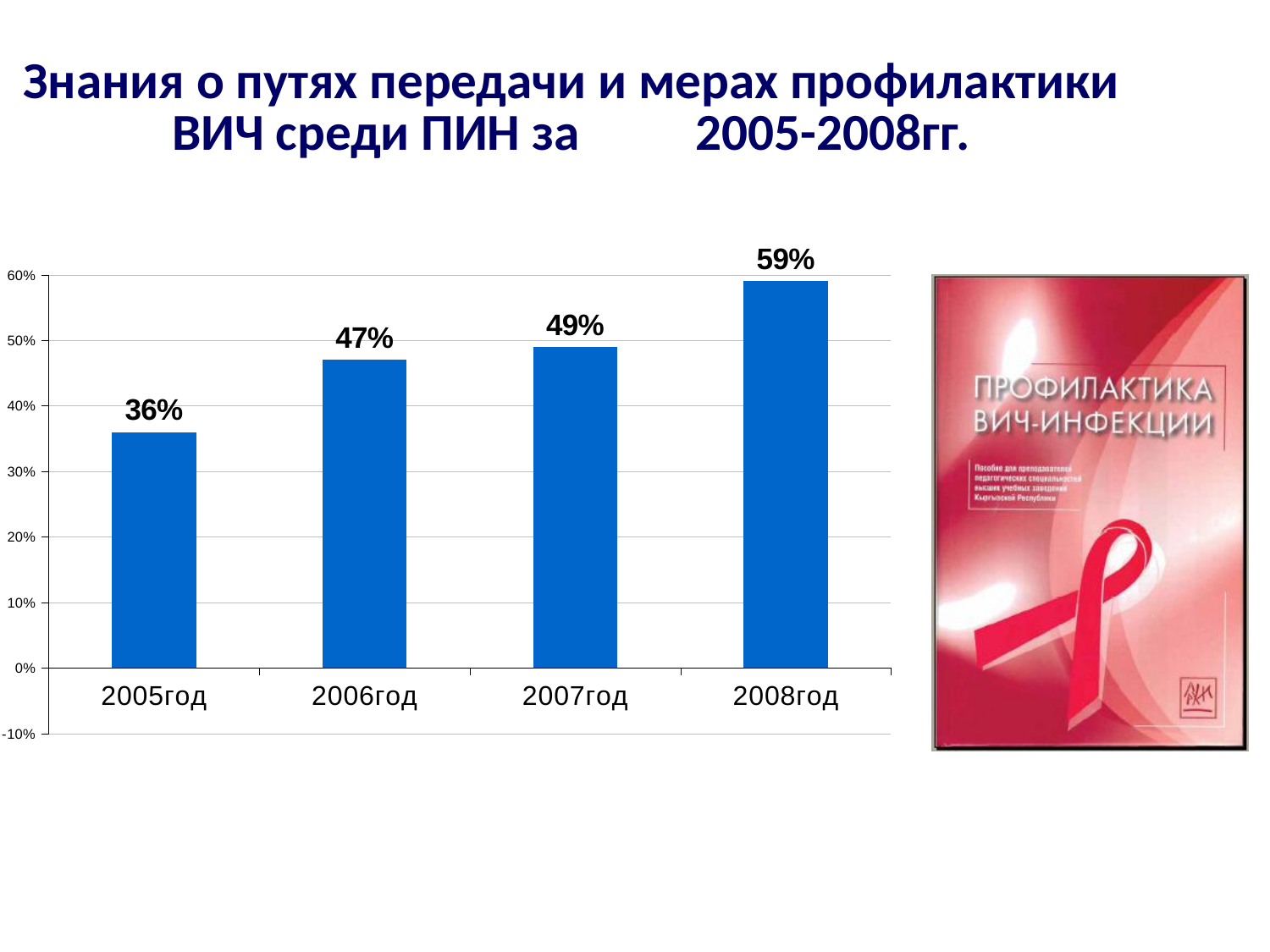
What kind of chart is shown on the slide? bar chart What is the value for 2005год? 36% Which year has the highest value? 2008год What is the difference between the values for 2008год and 2005год? 23% Which is larger, the value for 2006год or the value for 2008год? 2008год What is the value for 2006год? 47% What is the difference between the values for 2007год and 2006год? 2% How many years are shown on the x axis? 4 Which year has the lowest value? 2005год What is the value for 2008год? 59% What is the value for 2007год? 49% Do the values rise or fall from 2005год to 2008год? rise